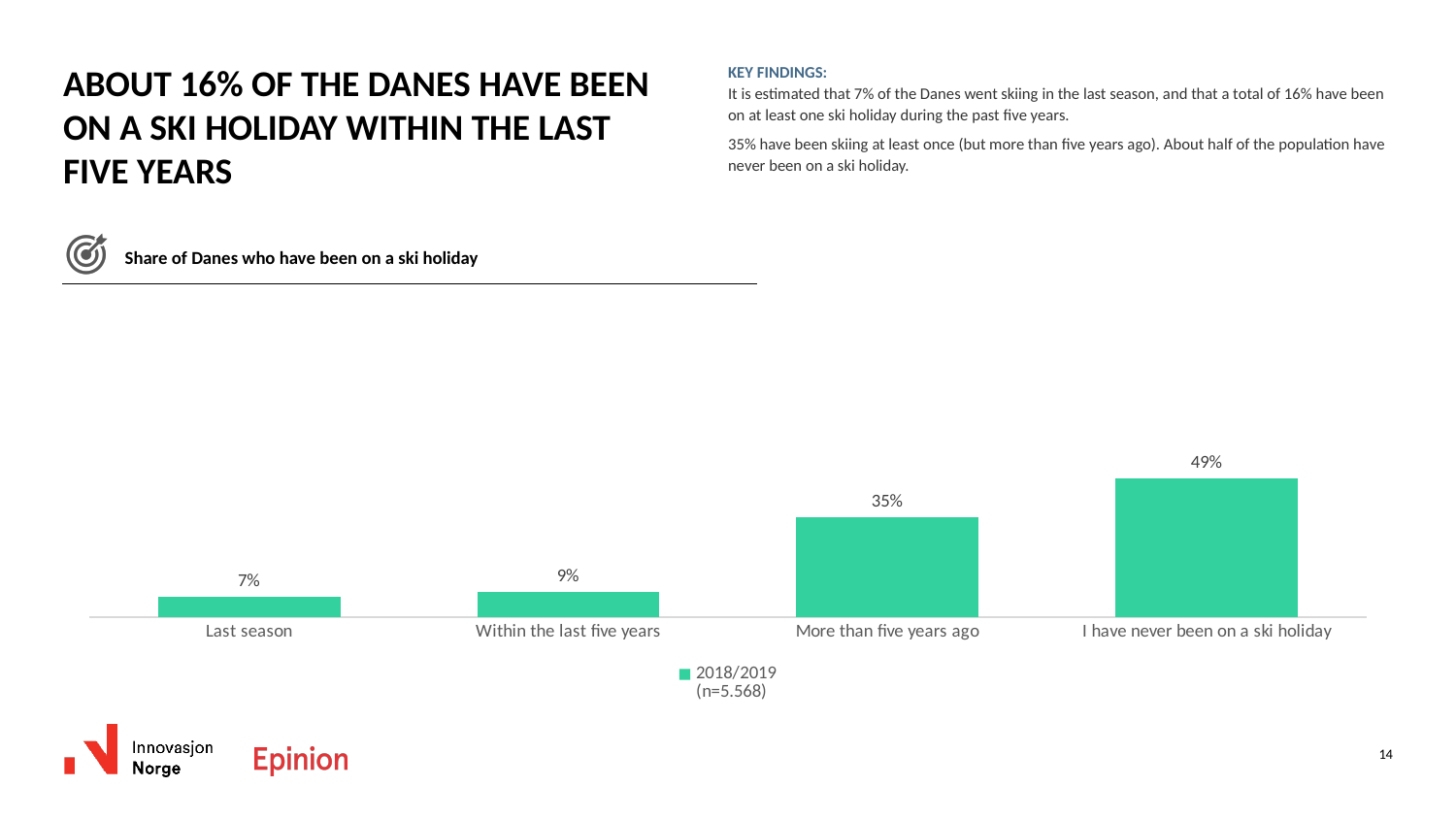
What is the value for "I have never been on a ski holiday"? 49% What is the value for "More than five years ago"? 35% How many categories are shown on the x axis? 4 What is the value for "Within the last five years"? 9% Which category has the lowest value? Last season What is the value for "Last season"? 7% How many series does the legend list? 1 Which is larger, the value for "Within the last five years" or the value for "Last season"? Within the last five years What is the legend entry for the series shown? 2018/2019 (n=5.568) What is the difference between the values for "I have never been on a ski holiday" and "More than five years ago"? 14% What kind of chart is shown on the slide? Bar chart Which category has the highest value? I have never been on a ski holiday